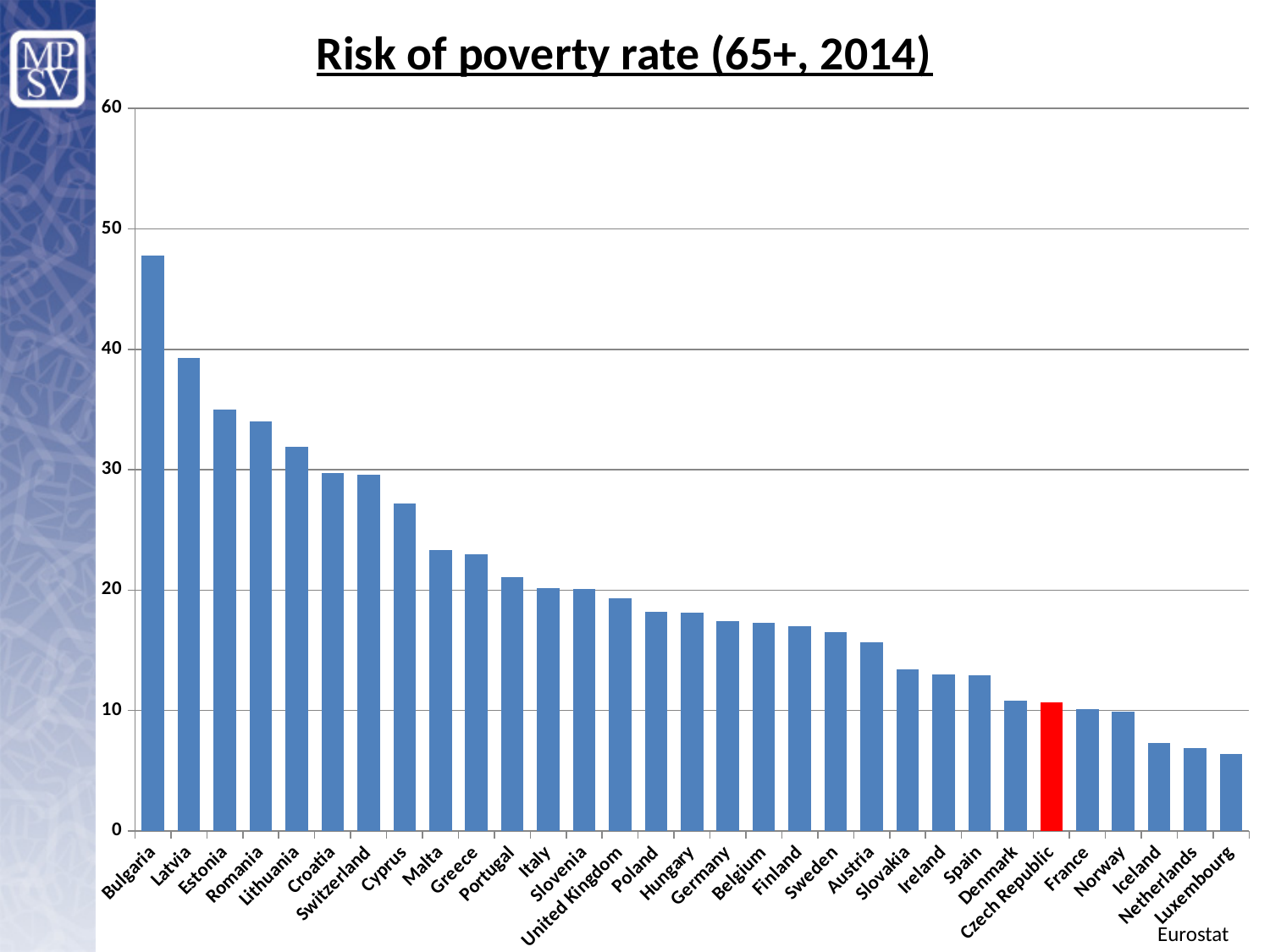
How many countries are shown on the x axis? 31 Which has a higher risk of poverty rate, Bulgaria or Latvia? Bulgaria Is the value for Bulgaria greater or less than 40? greater Is the value for Estonia greater or less than 30? greater What kind of chart is shown on the slide? bar chart Which country's bar is highlighted in red? Czech Republic Is the value for Cyprus greater or less than 30? less Which country has the lowest risk of poverty rate (65+, 2014)? Luxembourg Which country has the highest risk of poverty rate (65+, 2014)? Bulgaria Do the values rise or fall from left to right along the x axis? fall